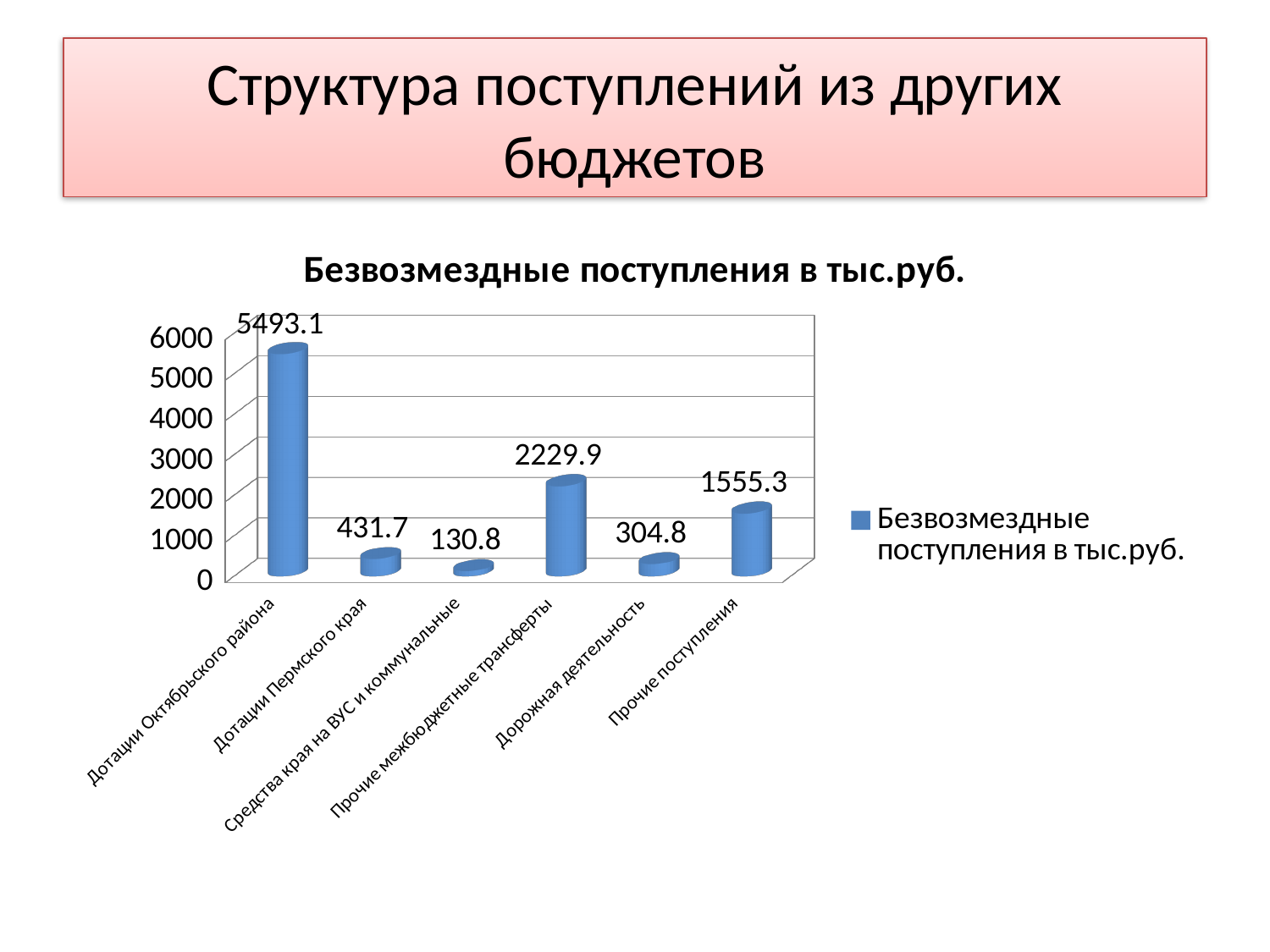
What is the difference between the values for Дотации Пермского края and Дорожная деятельность? 126.9 What is the title of the chart? Безвозмездные поступления в тыс.руб. What is the value for Дорожная деятельность? 304.8 Which category has the highest value? Дотации Октябрьского района Which is larger, the value for Прочие поступления or the value for Дотации Пермского края? Прочие поступления What is the value for Прочие межбюджетные трансферты? 2229.9 What is the difference between the values for Дотации Октябрьского района and Прочие межбюджетные трансферты? 3263.2 What kind of chart is this? bar chart How many categories are shown on the x axis? 6 What is the value for Дотации Октябрьского района? 5493.1 What is the value for Прочие поступления? 1555.3 Which category has the lowest value? Средства края на ВУС и коммунальные